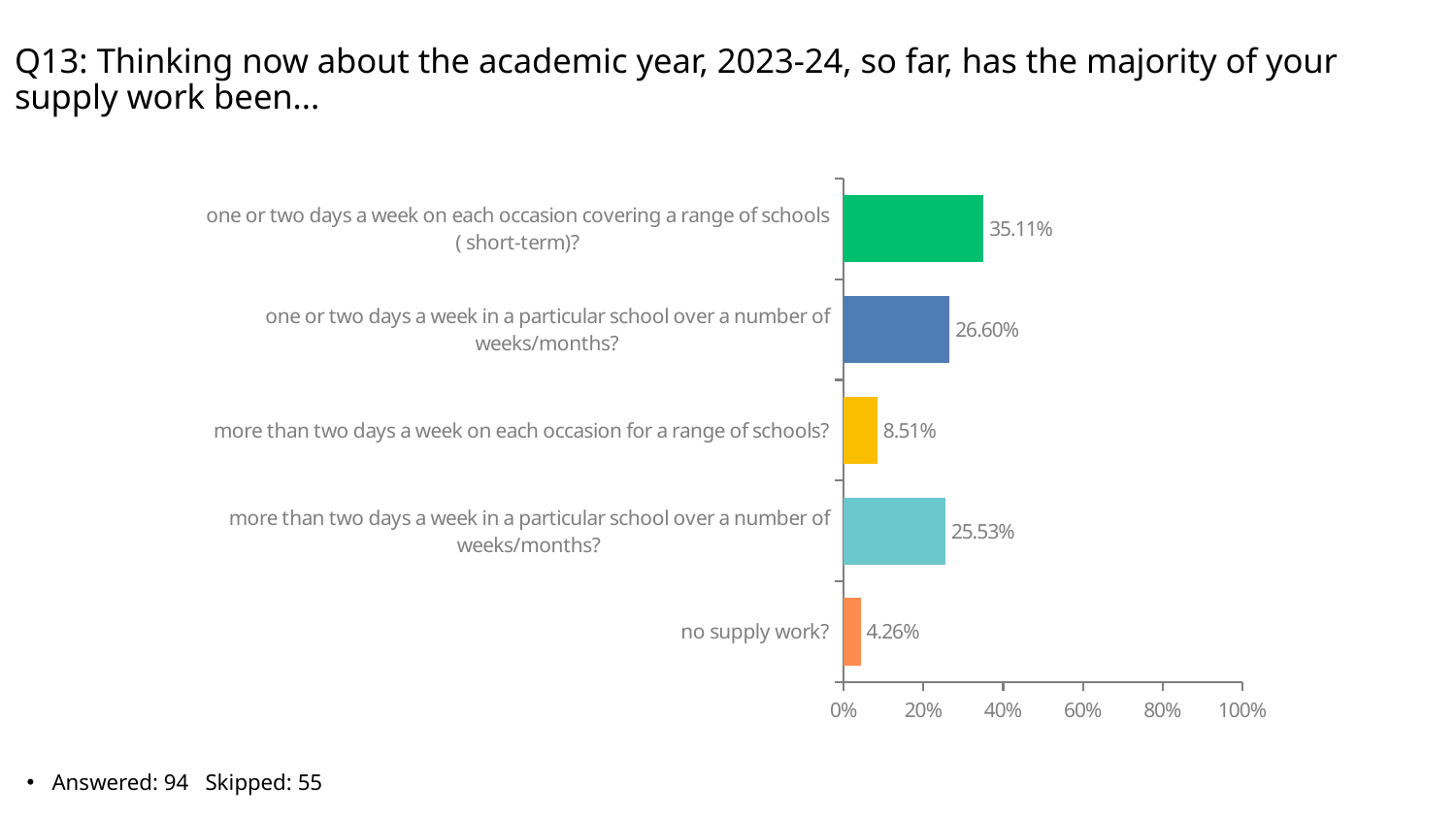
What percentage is shown for 'more than two days a week on each occasion for a range of schools?' 8.51% What is the value for 'more than two days a week in a particular school over a number of weeks/months?' 25.53% What is the difference between the value for 'one or two days a week in a particular school over a number of weeks/months?' and 'more than two days a week in a particular school over a number of weeks/months?' 1.07% Which category has the lowest percentage? no supply work? Is the value for 'one or two days a week on each occasion covering a range of schools (short-term)?' greater or less than 40%? less What kind of chart is shown on the slide? bar chart What is the value for 'no supply work?' 4.26% What percentage of respondents said their supply work was mostly one or two days a week on each occasion covering a range of schools (short-term)? 35.11% Which category has the highest percentage? one or two days a week on each occasion covering a range of schools ( short-term)? How many respondents answered this question according to the slide? 94 Which is larger: the value for 'more than two days a week on each occasion for a range of schools?' or 'no supply work?' more than two days a week on each occasion for a range of schools? How many categories are shown in the chart? 5